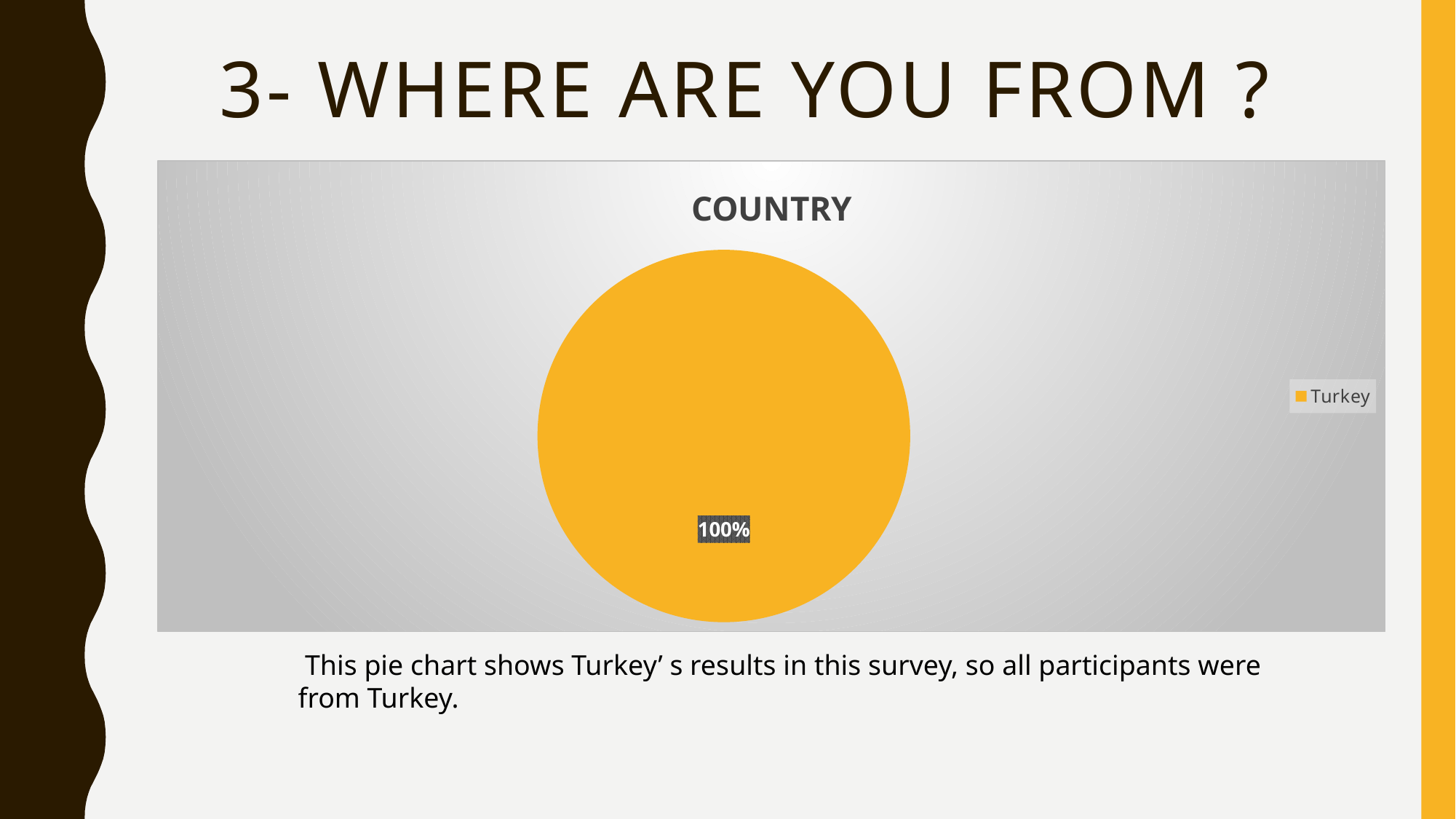
How many categories does the legend list? 1 How many slices does the pie chart have? 1 What is the title of the chart? COUNTRY What is the data label shown on the pie slice? 100% What share of the pie does Turkey account for? 100% Which country is listed in the legend? Turkey What kind of chart is shown on the slide? pie chart